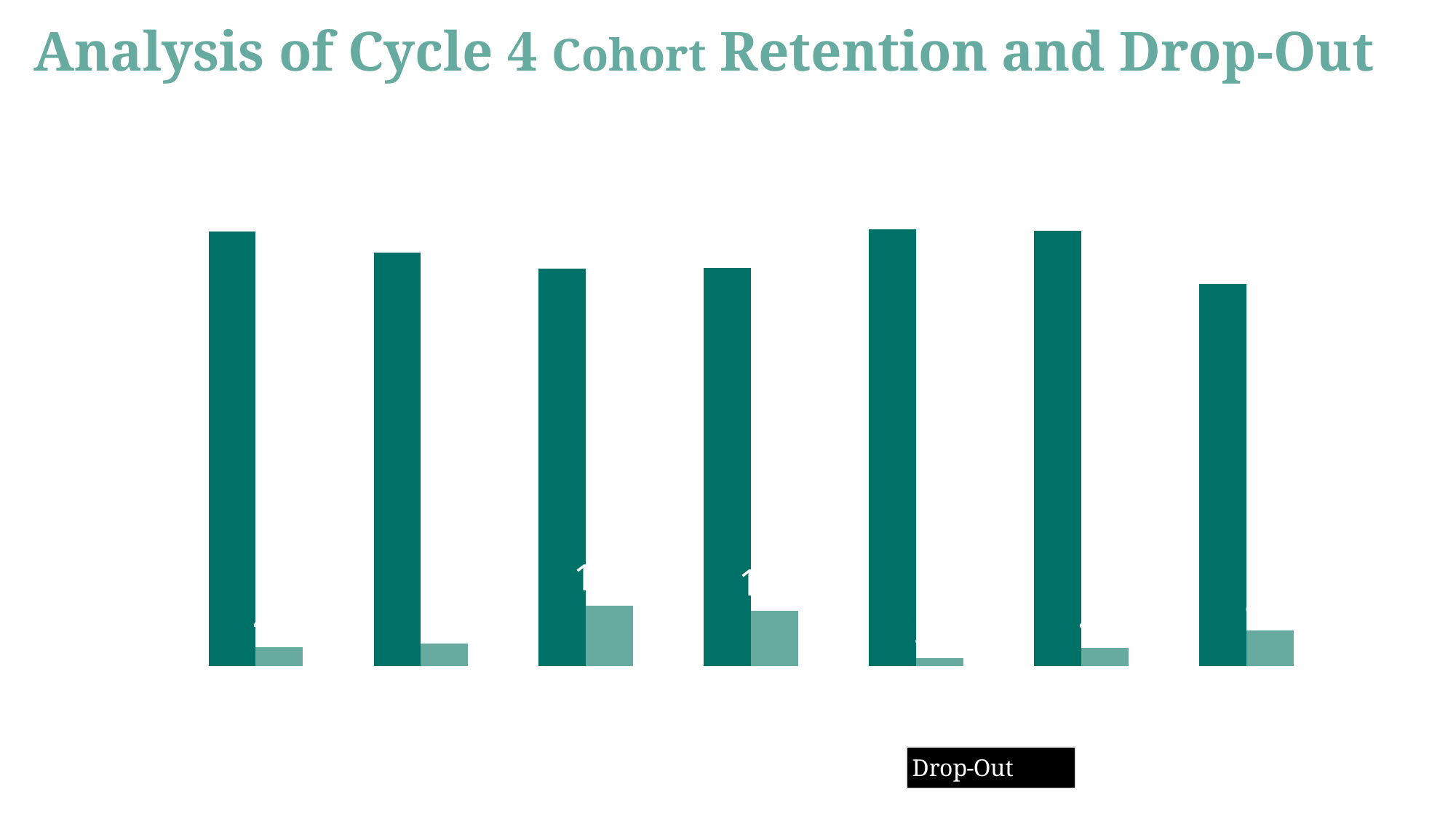
What is the title of the slide? Analysis of Cycle 4 Cohort Retention and Drop-Out Which series name is shown in the legend box at the bottom of the chart? Drop-Out In the rightmost group of bars, is the light teal bar taller or shorter than the dark teal bar? shorter In the leftmost group of bars, which bar is taller, the dark teal bar or the light teal bar? the dark teal bar Which group of bars, counting from the left, has the shortest dark teal bar? the seventh (rightmost) group Which group of bars, counting from the left, has the shortest light teal bar? the fifth group How many groups of bars are plotted in the chart? 7 What kind of chart is shown on the slide? bar chart